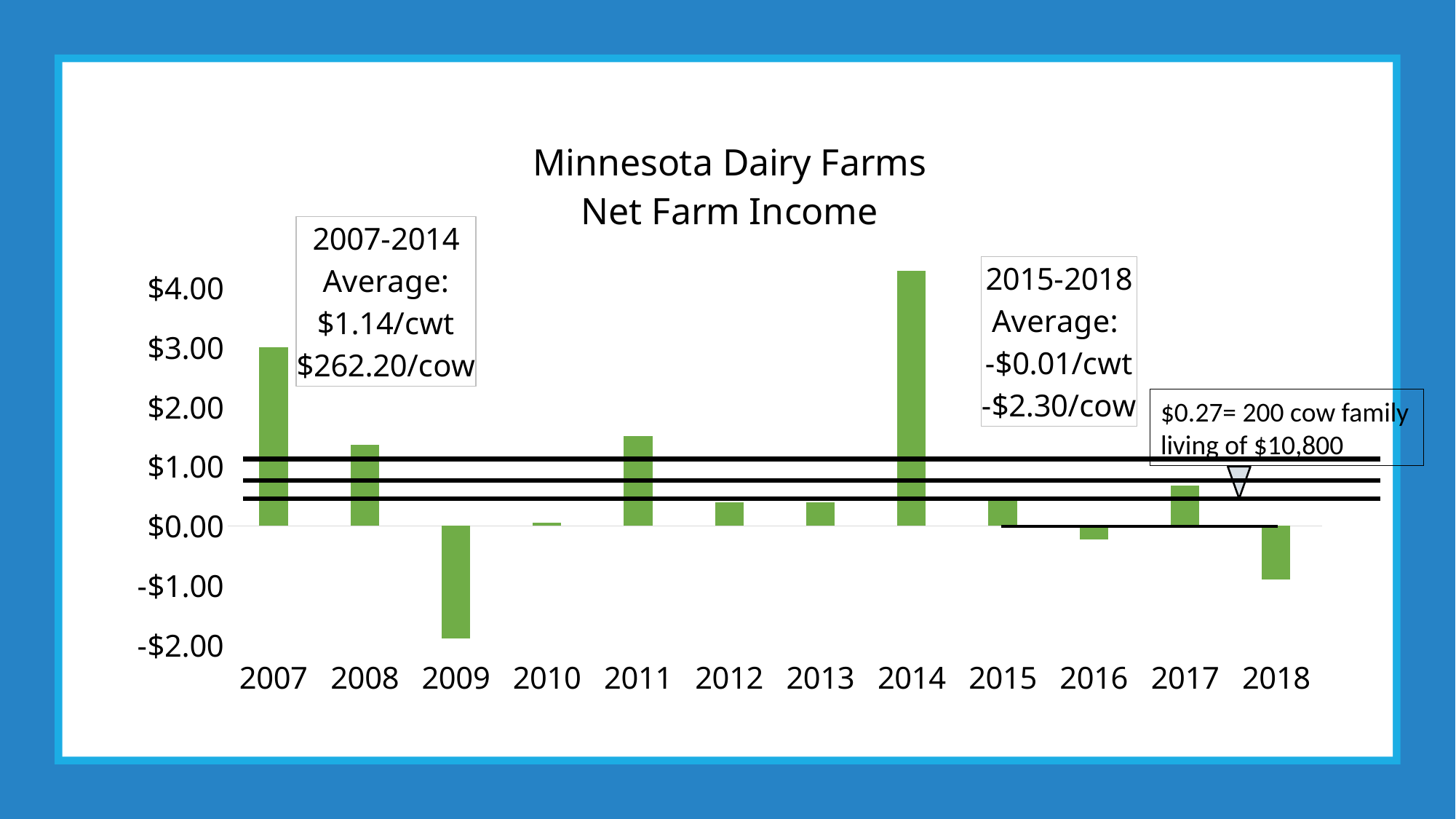
Which year has the larger net farm income, 2009 or 2018? 2018 What kind of chart is shown on the slide? bar chart According to the annotation on the chart, what is the 2007-2014 average net farm income per cwt? $1.14/cwt Is the value for 2018 greater or less than $0.00? less Is the value for 2011 greater or less than $1.00? greater Which year has the lowest net farm income in the chart? 2009 Which year has the larger net farm income, 2007 or 2008? 2007 Which year has the highest net farm income in the chart? 2014 What is the title of the chart? Minnesota Dairy Farms Net Farm Income How many years are shown on the x axis of the chart? 12 Is the value for 2009 greater or less than -$1.00? less